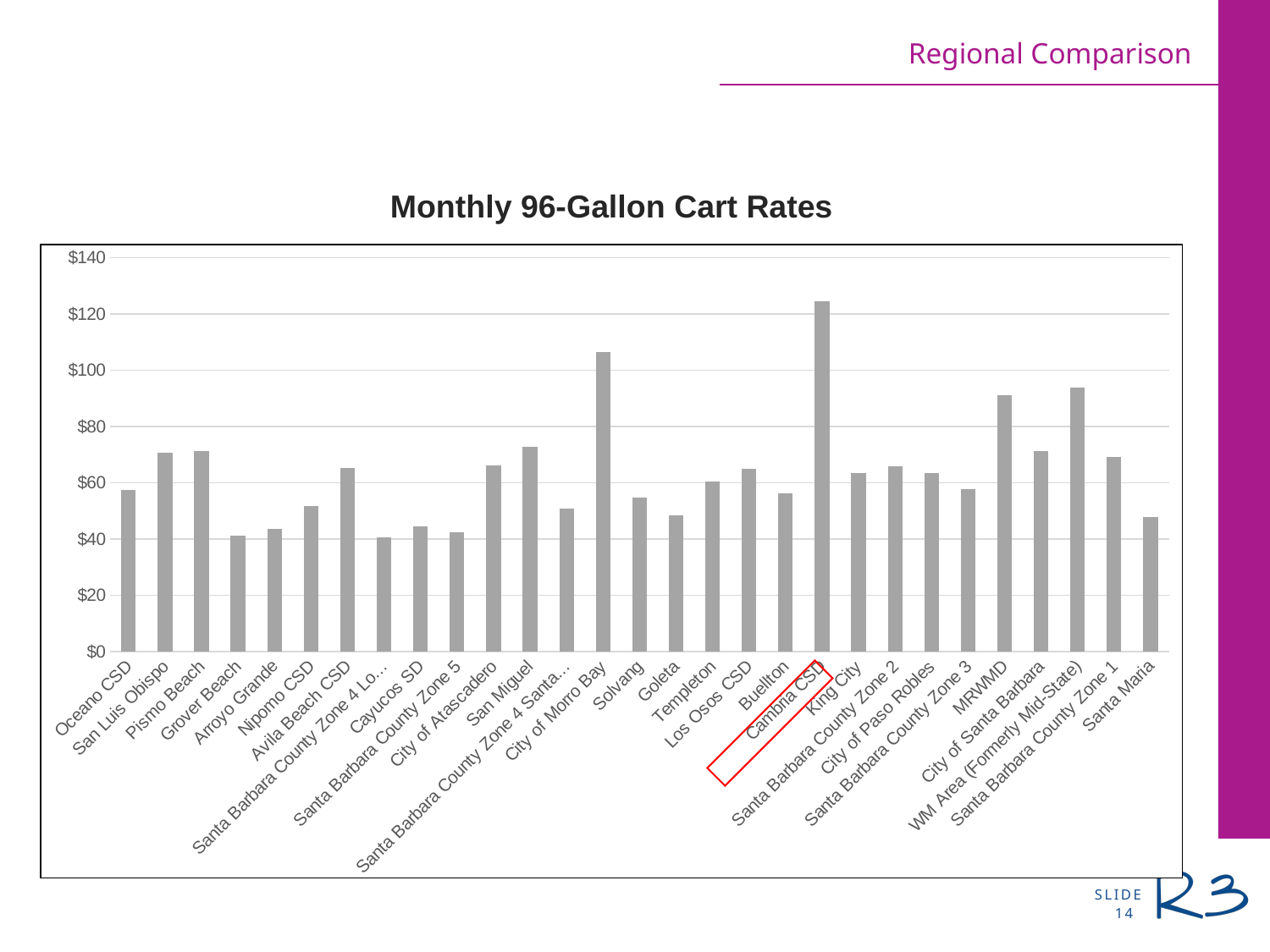
Is the value for Grover Beach greater or less than $60? less Which has the larger value, Cambria CSD or City of Morro Bay? Cambria CSD Which has the larger value, City of Morro Bay or MRWMD? City of Morro Bay How many categories are plotted on the x axis? 29 What is the title of the chart? Monthly 96-Gallon Cart Rates What kind of chart is shown on the slide? bar chart Is the value for Santa Maria greater or less than $60? less Which category has the highest monthly 96-gallon cart rate? Cambria CSD Is the value for City of Morro Bay greater or less than $100? greater Which category label on the x axis is outlined in red? Cambria CSD